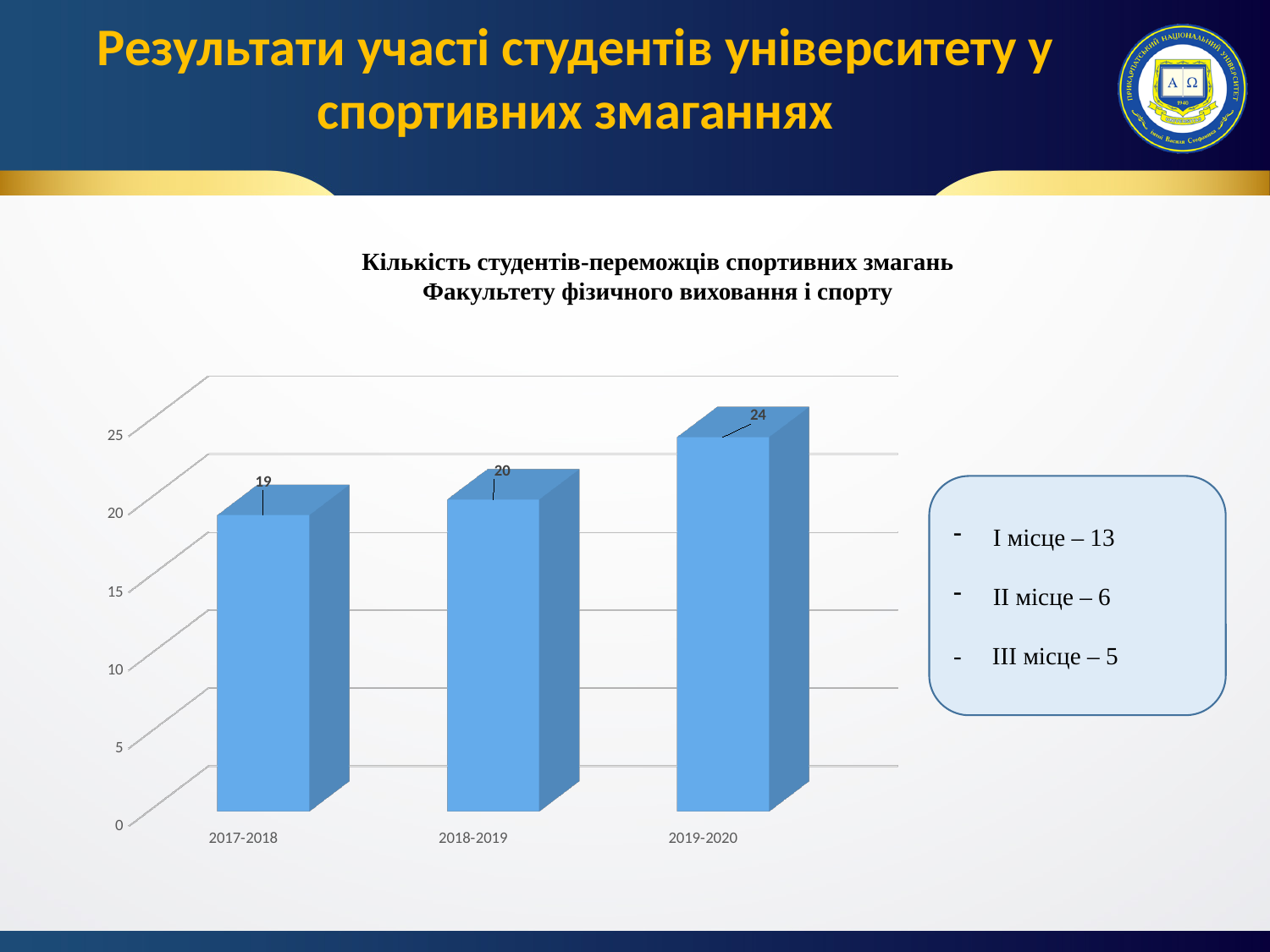
Which is larger, the value for 2018-2019 or the value for 2019-2020? 2019-2020 What is the value for 2018-2019? 20 What is the value for 2017-2018? 19 What is the difference between the values for 2019-2020 and 2018-2019? 4 Do the values rise or fall from 2017-2018 to 2019-2020? rise What is the difference between the values for 2019-2020 and 2017-2018? 5 What kind of chart is shown on the slide? bar chart Is the value for 2019-2020 greater or less than 20? greater Which academic year has the lowest value? 2017-2018 How many academic years are shown on the x axis? 3 Which academic year has the highest value? 2019-2020 What is the value for 2019-2020? 24